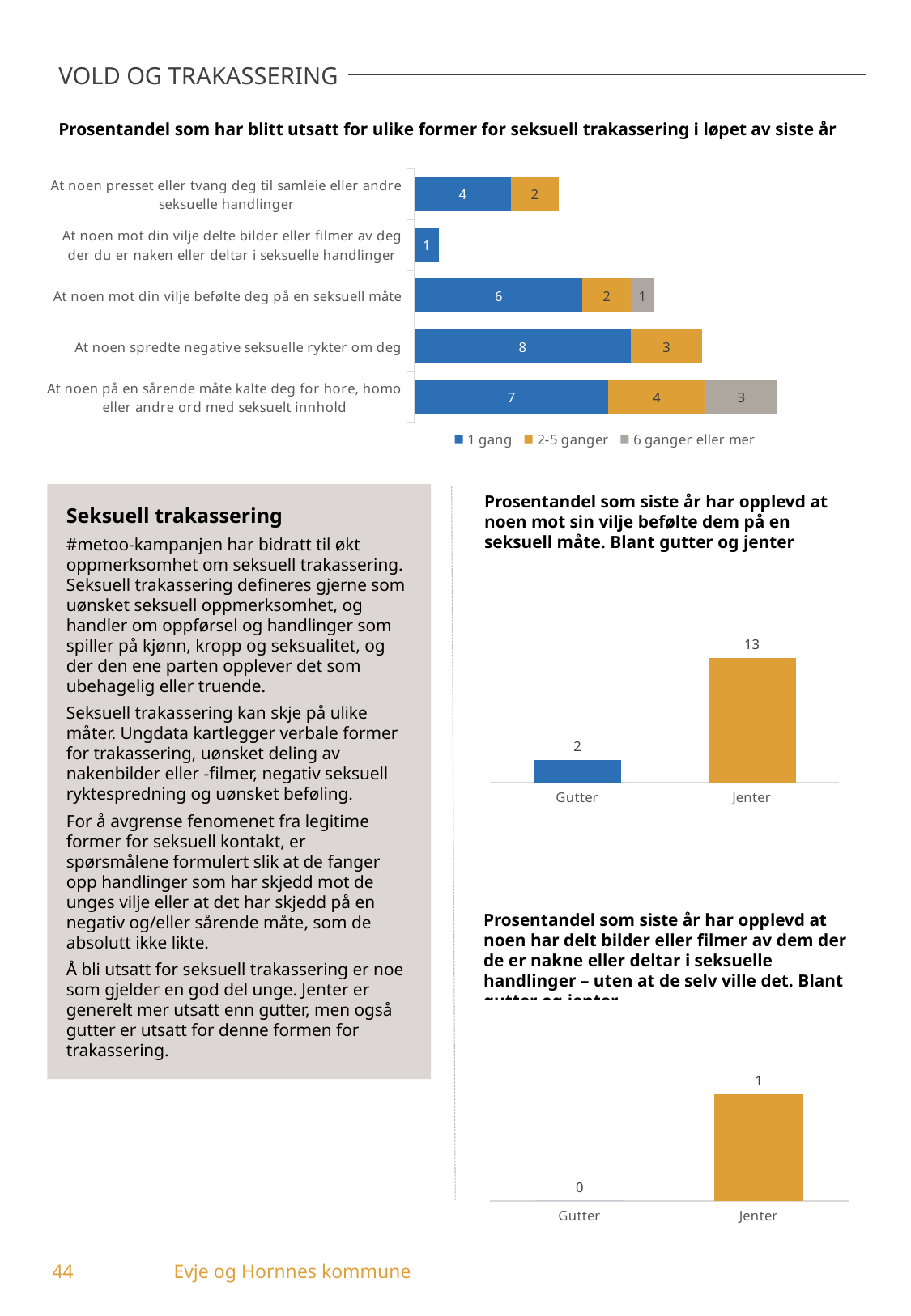
In the top chart, what is the total of the stacked bar for 'At noen mot din vilje befølte deg på en seksuell måte'? 9 In the top chart, how many series does the legend list? 3 In the top chart, what is the value for '1 gang' for 'At noen spredte negative seksuelle rykter om deg'? 8 In the top chart, which category has the lowest total? At noen mot din vilje delte bilder eller filmer av deg der du er naken eller deltar i seksuelle handlinger In the top chart, what is the value for '6 ganger eller mer' for 'At noen på en sårende måte kalte deg for hore, homo eller andre ord med seksuelt innhold'? 3 In the top chart, how many categories are shown? 5 In the middle chart about 'befølte dem på en seksuell måte', what is the difference between Jenter and Gutter? 11 In the top chart, what type of chart is it? Stacked bar chart In the middle chart about 'befølte dem på en seksuell måte', what is the value for Jenter? 13 In the bottom chart about 'delt bilder eller filmer', what is the value for Gutter? 0 In the bottom chart about 'delt bilder eller filmer', which is larger, Gutter or Jenter? Jenter In the top chart, what is the total of the stacked bar for 'At noen på en sårende måte kalte deg for hore, homo eller andre ord med seksuelt innhold'? 14